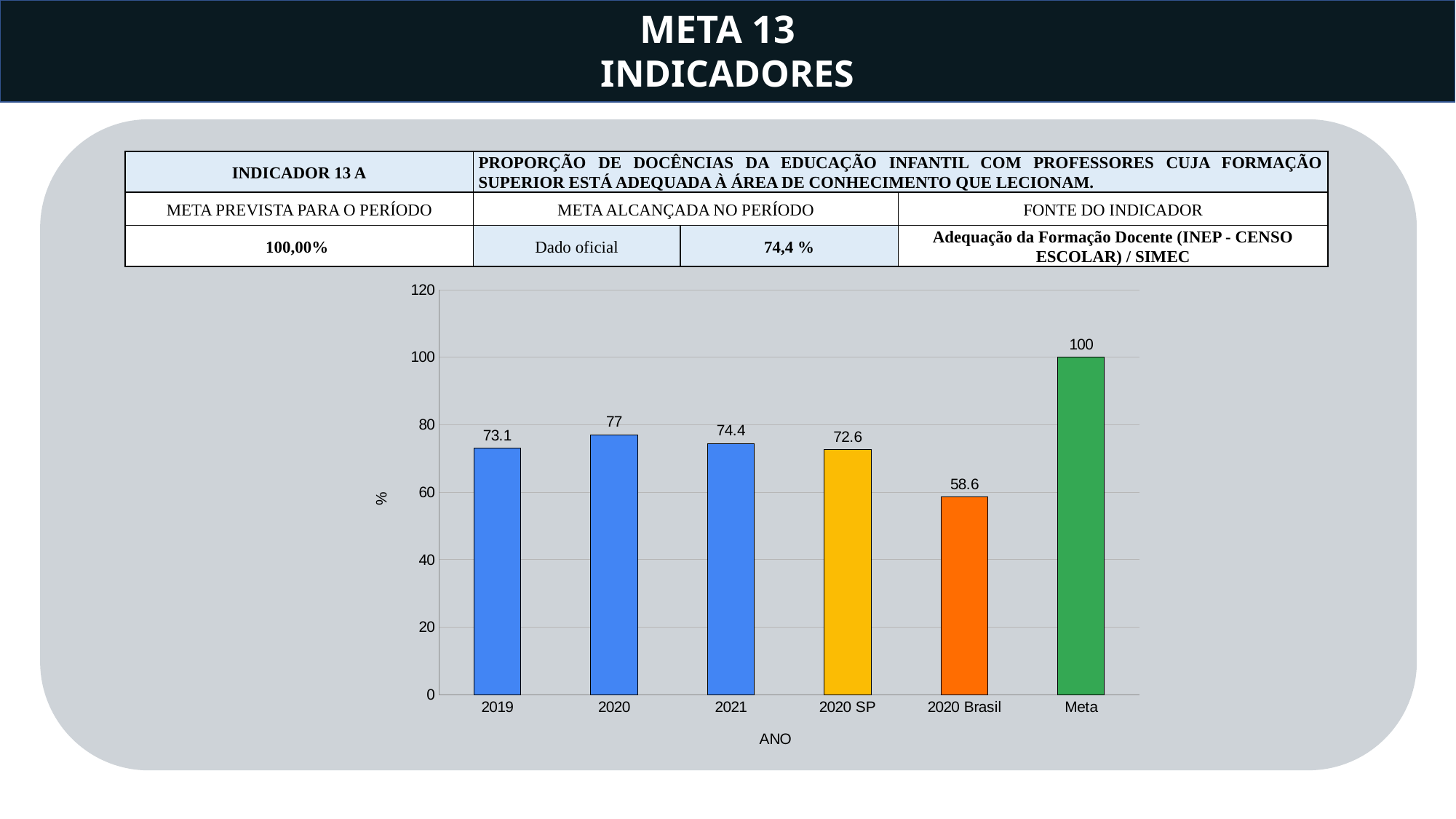
What is the value for 2019? 73.1 How many bars are shown in the chart? 6 Which is larger, the value for 2020 or the value for 2019? 2020 What is the value for 2020 Brasil? 58.6 Is the value for 2020 Brasil greater or less than 60? less What is the difference between the 2020 SP value and the 2020 Brasil value? 14 What is the difference between the Meta value and the 2021 value? 25.6 Which category has the lowest value? 2020 Brasil What kind of chart is shown on the slide? bar chart What is the label of the x axis? ANO Which category has the highest value? Meta What is the value for 2020 SP? 72.6